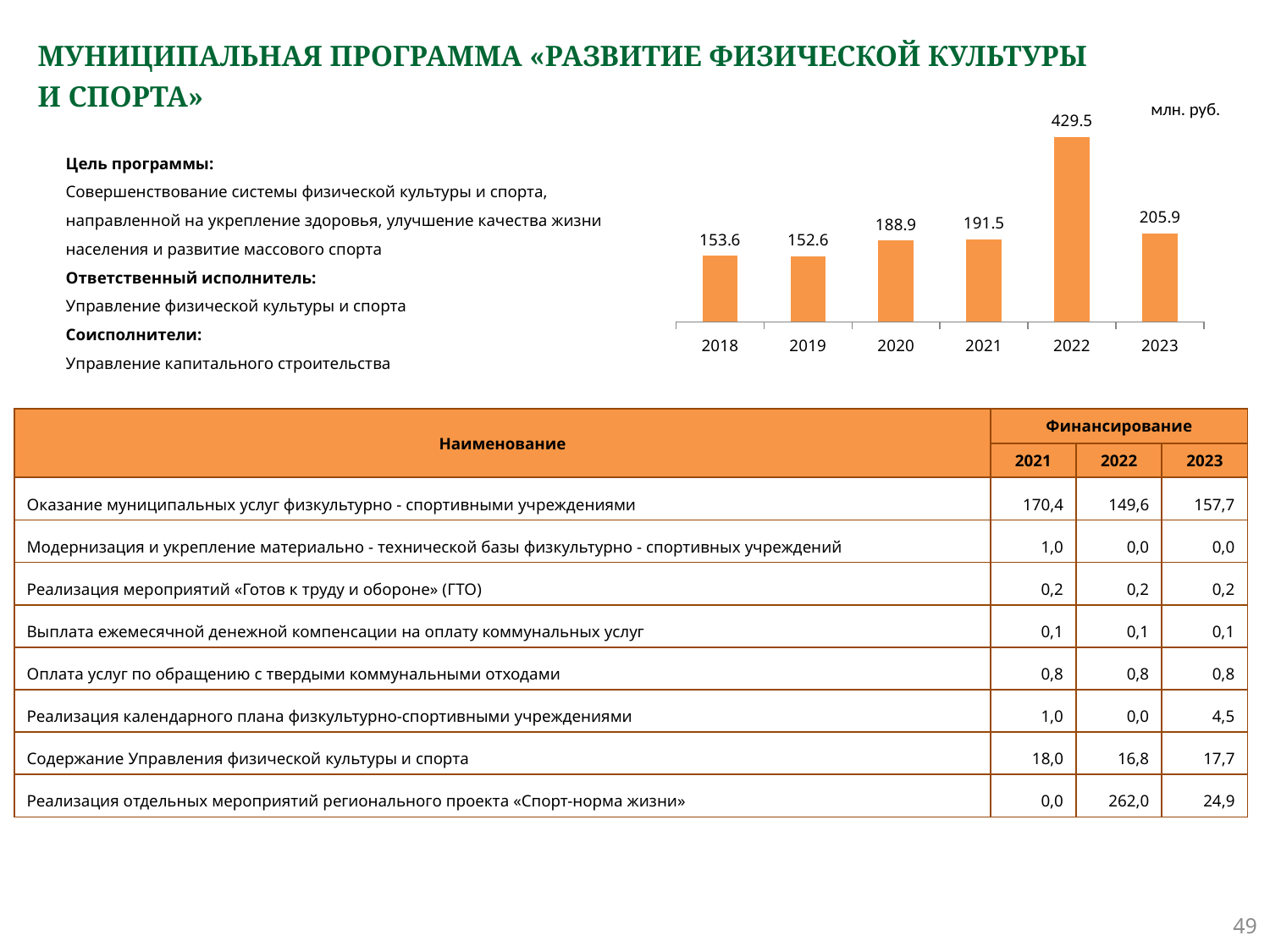
Which year has the highest value on the bar chart? 2022 What is the difference between the values for 2021 and 2020 on the bar chart? 2.6 How many years are shown on the bar chart? 6 Which year has the lowest value on the bar chart? 2019 What kind of chart is shown on the slide? bar chart What is the value for 2022 on the bar chart? 429.5 What is the difference between the values for 2022 and 2023 on the bar chart? 223.6 Do the values on the bar chart rise or fall from 2019 to 2022? rise What is the value for 2018 on the bar chart? 153.6 Which is larger on the bar chart, the value for 2020 or the value for 2023? 2023 What unit is indicated for the values on the bar chart? млн. руб. What is the value for 2023 on the bar chart? 205.9